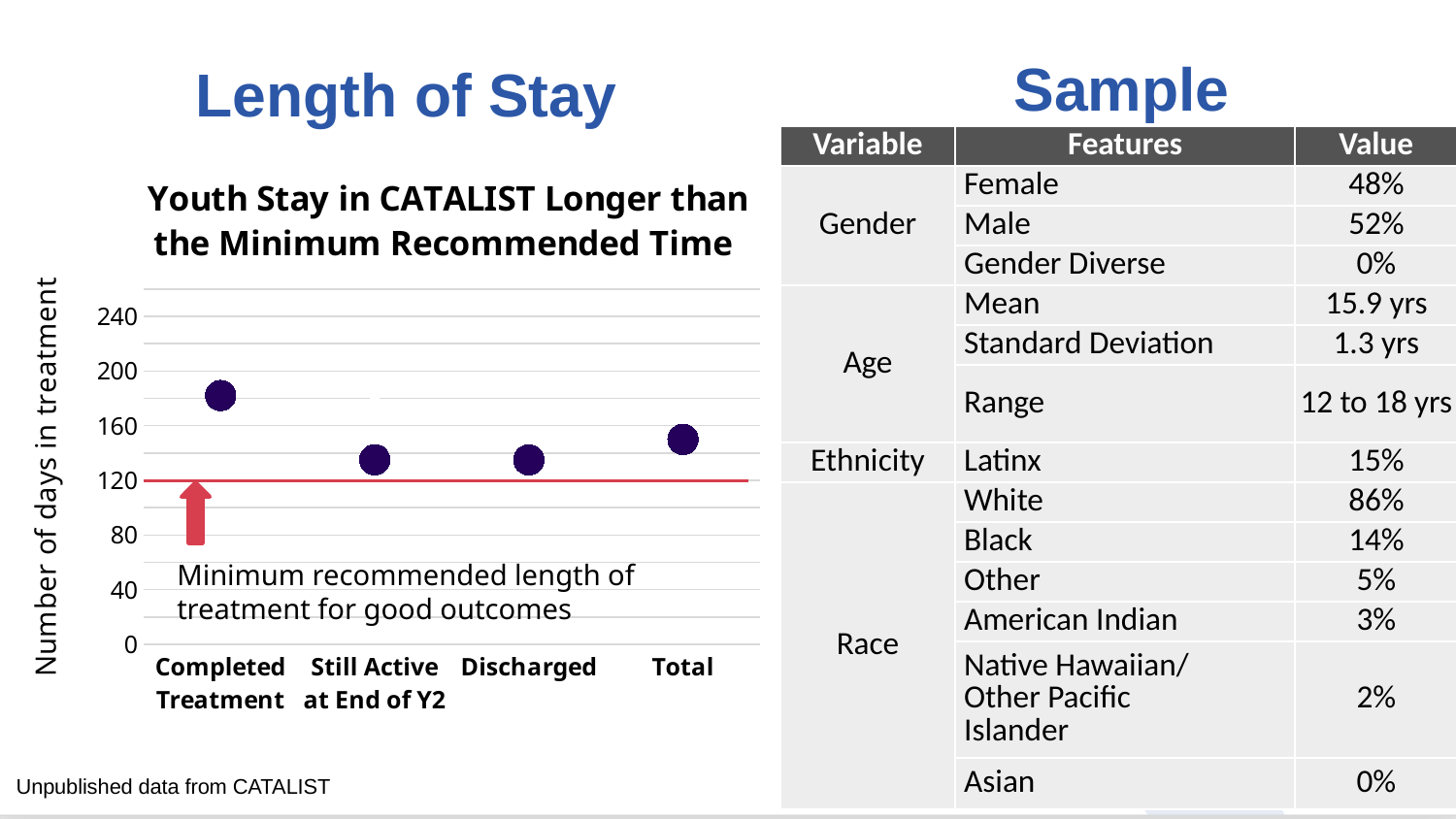
Is the value for Completed Treatment greater or less than 200? less Which is larger, the value for Total or the value for Still Active at End of Y2? Total Which category has the highest number of days in treatment? Completed Treatment Which is larger, the value for Completed Treatment or the value for Total? Completed Treatment What does the red horizontal line on the chart represent? Minimum recommended length of treatment for good outcomes Is the value for Discharged greater or less than 160? less What kind of chart is shown on the slide? scatter chart How many categories are plotted on the x axis of the chart? 4 What is the title of the chart? Youth Stay in CATALIST Longer than the Minimum Recommended Time Is the value for Still Active at End of Y2 greater or less than 120? greater